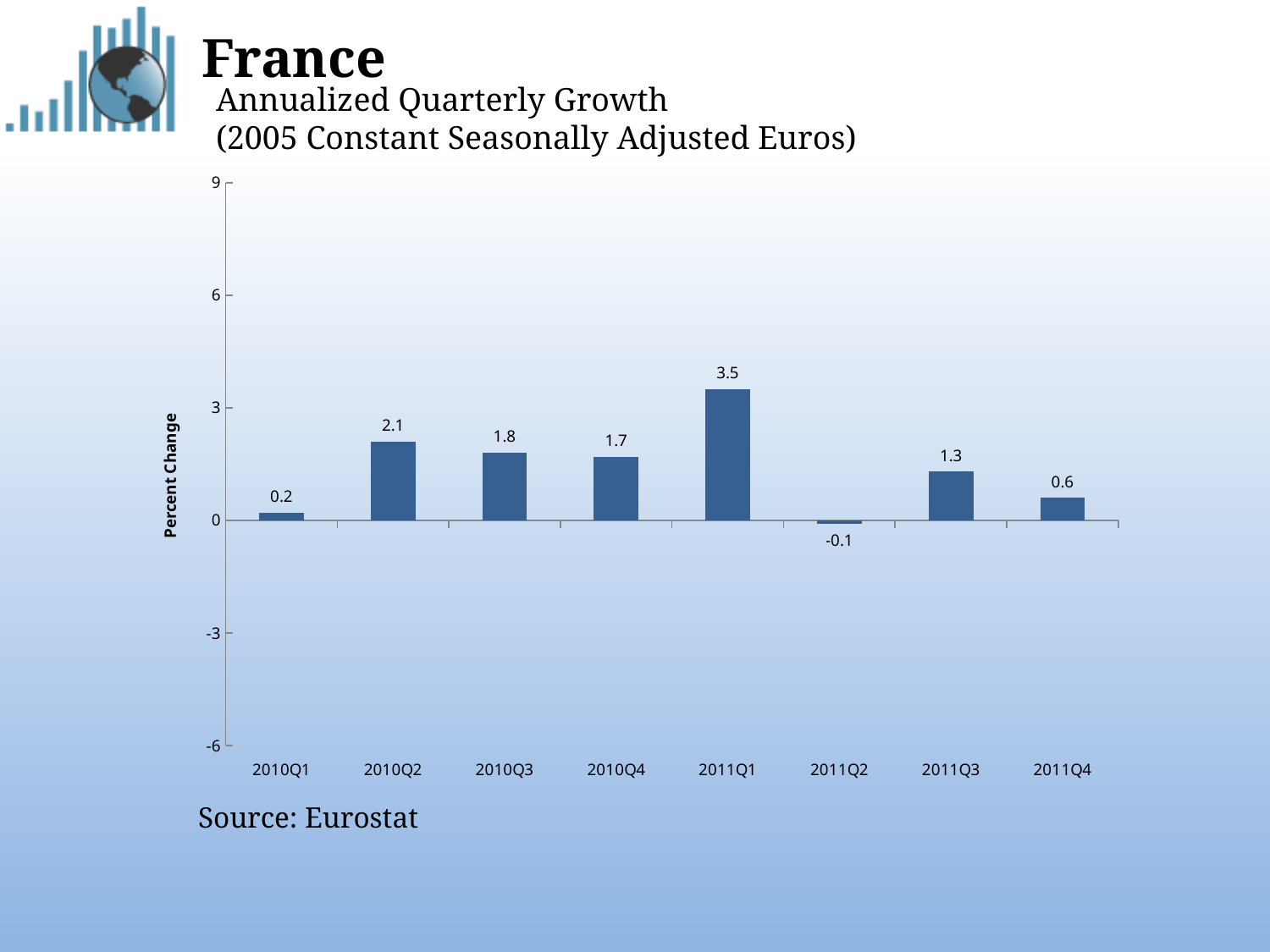
What is the annualized quarterly growth value for 2011Q1? 3.5 What is the difference between the values for 2011Q1 and 2010Q2? 1.4 What is the label on the vertical axis? Percent Change Which is larger, the value for 2010Q3 or the value for 2011Q3? 2010Q3 Is the value for 2011Q1 greater or less than 3? greater Which quarter has the highest annualized growth? 2011Q1 What kind of chart is shown on the slide? Bar chart What is the value shown for 2011Q2? -0.1 What is the value shown for 2010Q1? 0.2 Which quarter has the lowest annualized growth? 2011Q2 What is the source cited for the chart data? Eurostat How many quarters are plotted on the chart? 8